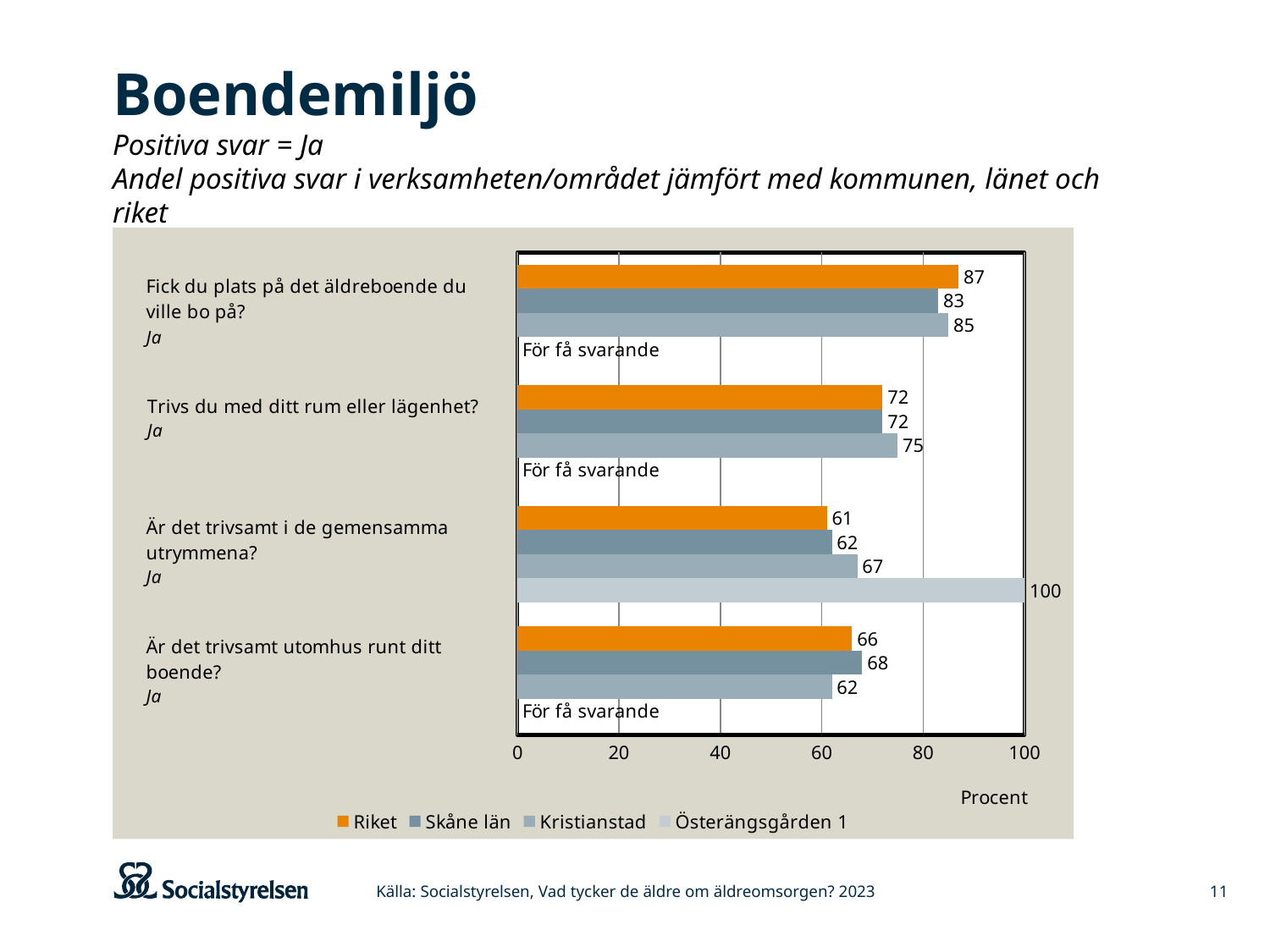
For the question "Är det trivsamt i de gemensamma utrymmena?", which is larger: the value for Kristianstad or the value for Riket? Kristianstad What is the value for Skåne län for the question "Är det trivsamt utomhus runt ditt boende?"? 68 What unit is labelled on the horizontal axis of the chart? Procent What is the difference between the Riket and Skåne län values for the question "Fick du plats på det äldreboende du ville bo på?"? 4 How many series does the legend list? 4 What is the value for Österängsgården 1 for the question "Är det trivsamt i de gemensamma utrymmena?"? 100 What is the value for Riket for the question "Fick du plats på det äldreboende du ville bo på?"? 87 Which series has the highest value for the question "Är det trivsamt i de gemensamma utrymmena?"? Österängsgården 1 What is shown for Österängsgården 1 for the question "Trivs du med ditt rum eller lägenhet?"? För få svarande What is the value for Kristianstad for the question "Trivs du med ditt rum eller lägenhet?"? 75 What kind of chart is shown on the slide? Bar chart Which series has the lowest value for the question "Är det trivsamt utomhus runt ditt boende?"? Kristianstad